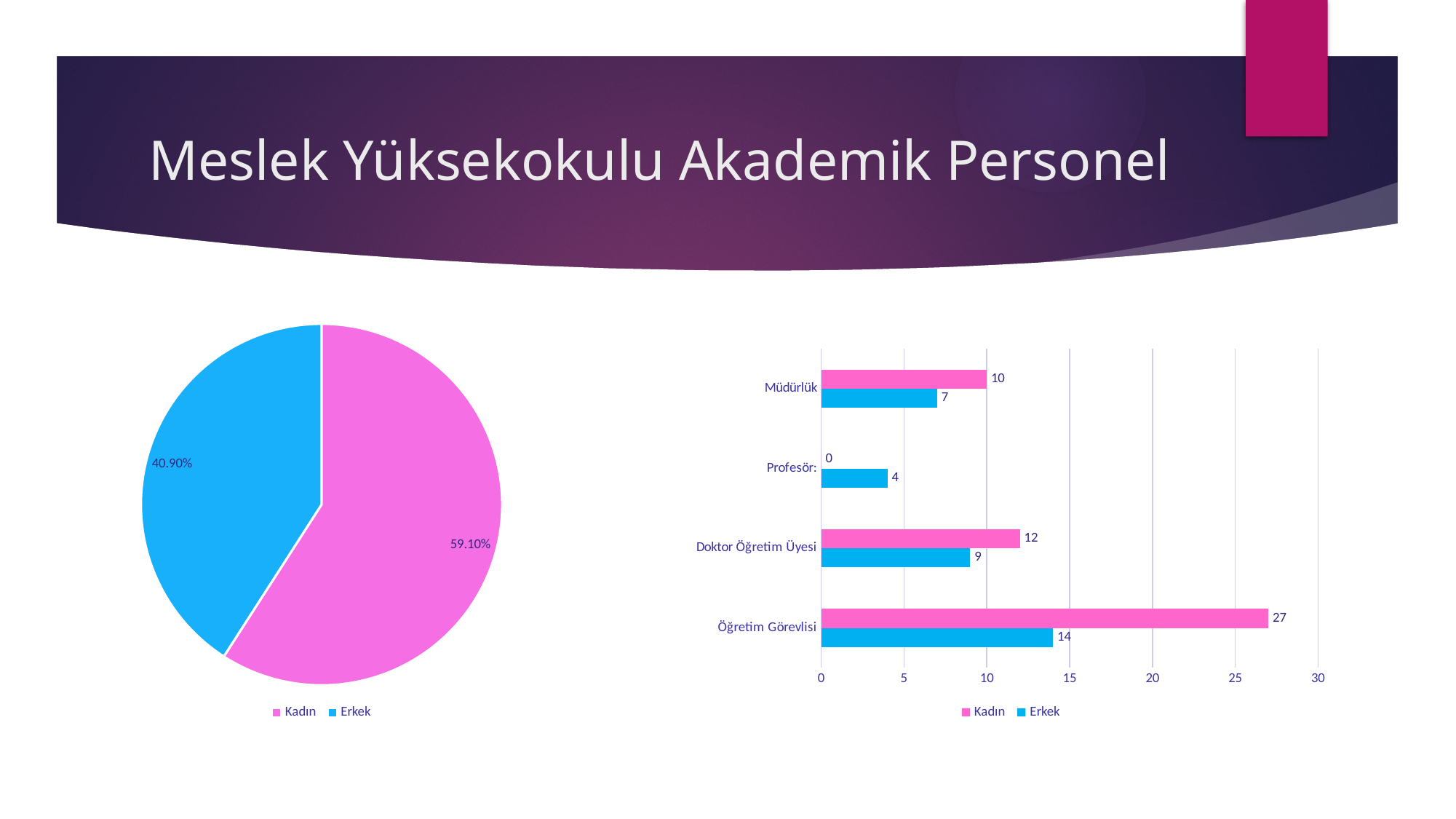
What kind of chart is the chart on the left? pie chart In the bar chart on the right, what is the difference between the Kadın and Erkek values for Doktor Öğretim Üyesi? 3 In the bar chart on the right, what is the Erkek value for Profesör? 4 What kind of chart is the chart on the right? bar chart In the pie chart on the left, what share does Kadın have? 59.10% In the bar chart on the right, what is the Kadın value for Öğretim Görevlisi? 27 In the bar chart on the right, which category has the highest Kadın value? Öğretim Görevlisi In the pie chart on the left, what share does Erkek have? 40.90% In the bar chart on the right, what is the Erkek value for Müdürlük? 7 How many categories does the bar chart on the right show? 4 In the pie chart on the left, which slice is larger, Kadın or Erkek? Kadın In the bar chart on the right, which category has the lowest Erkek value? Profesör